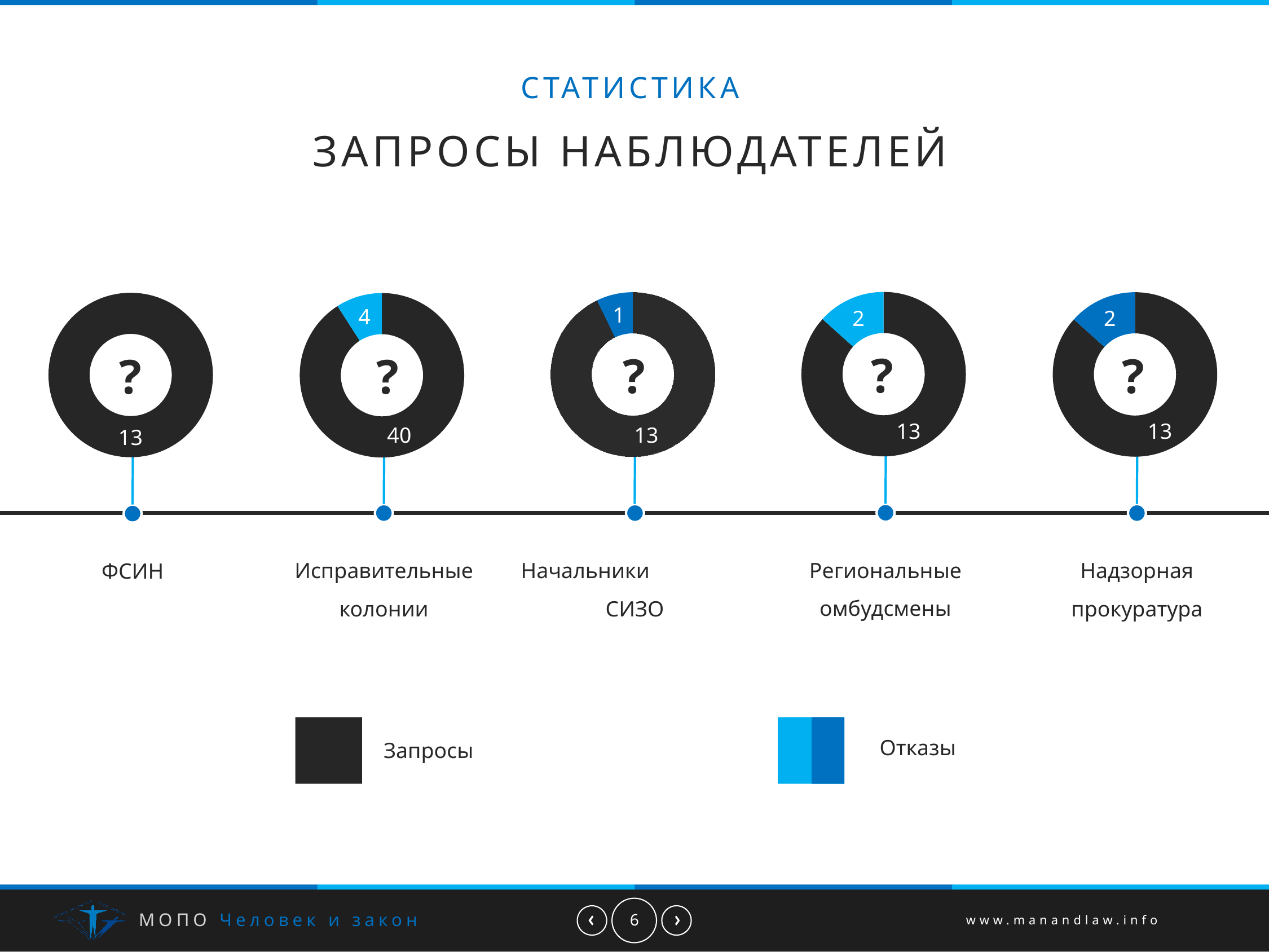
What is the difference between the Запросы value for Исправительные колонии and the Запросы value for ФСИН? 27 In the donut chart for Начальники СИЗО, what is the value for Отказы? 1 In the donut chart for Исправительные колонии, what is the value for Запросы? 40 Which is larger: the Отказы value for Исправительные колонии or the Отказы value for Региональные омбудсмены? Исправительные колонии What kind of chart is used for each category on the slide? Donut chart In the donut chart for Исправительные колонии, what is the value for Отказы? 4 In the donut chart for Надзорная прокуратура, what is the value for Отказы? 2 Which donut chart shows the lowest non-zero value for Отказы? Начальники СИЗО How many series does the legend list? 2 Which of the five donut charts shows the highest value for Запросы? Исправительные колонии In the donut chart for Региональные омбудсмены, what is the value for Запросы? 13 How many donut charts are shown on the slide? 5